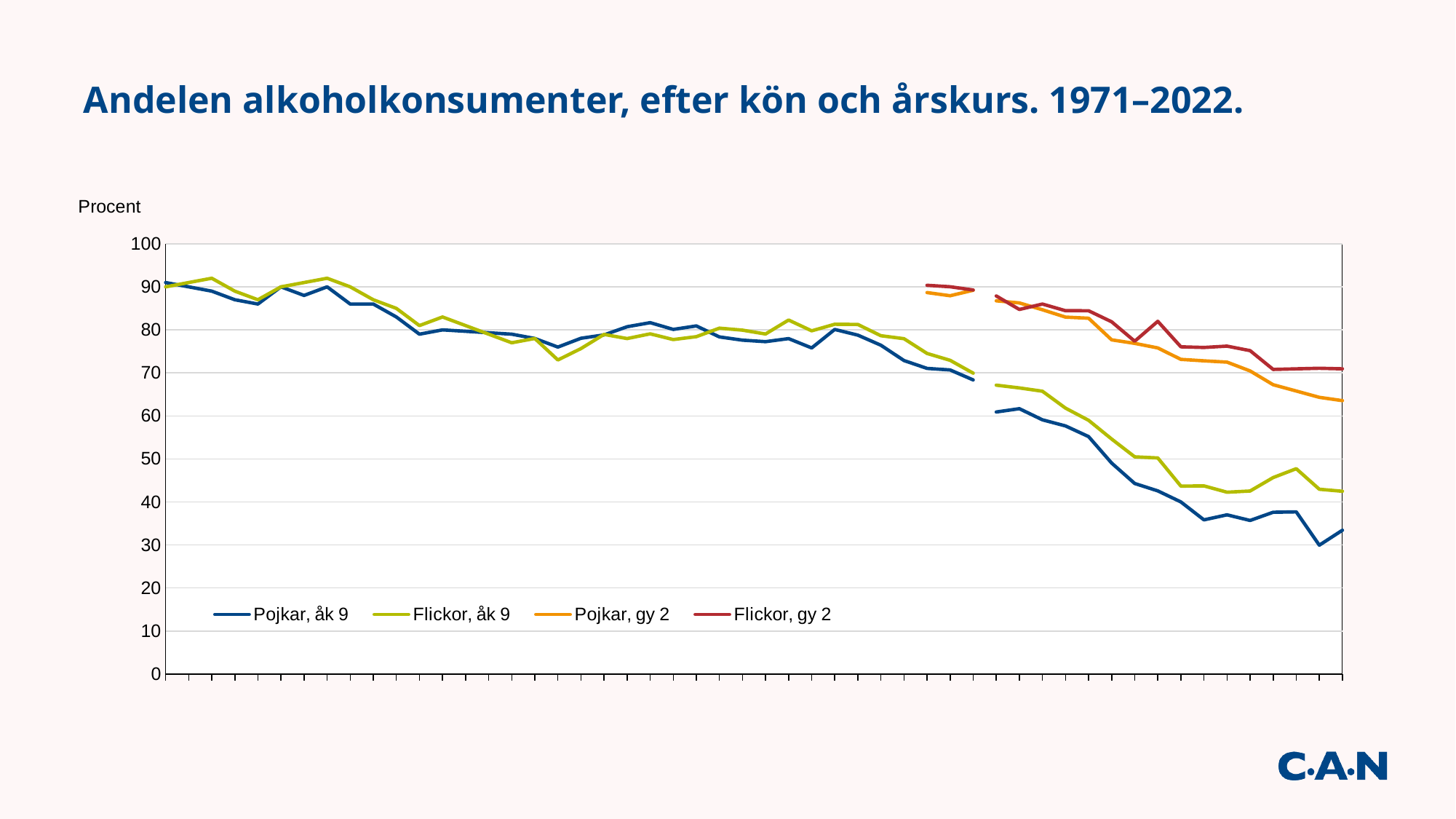
How many series does the legend list? 4 Is the final value for Pojkar, åk 9 greater or less than 40? less Is the final value for Pojkar, gy 2 greater or less than 70? less What label is shown on the vertical axis of the chart? Procent What kind of chart is shown on the slide? Line chart Is the final value for Flickor, gy 2 greater or less than 60? greater Overall, do the values for Pojkar, åk 9 rise or fall from left to right along the x axis? fall Which series ends at the lowest value at the right-hand end of the chart? Pojkar, åk 9 At the right-hand end of the chart, which is higher: Pojkar, gy 2 or Flickor, gy 2? Flickor, gy 2 Which series ends at the highest value at the right-hand end of the chart? Flickor, gy 2 At the right-hand end of the chart, which is higher: Pojkar, åk 9 or Flickor, åk 9? Flickor, åk 9 What is the title of the chart? Andelen alkoholkonsumenter, efter kön och årskurs. 1971–2022.